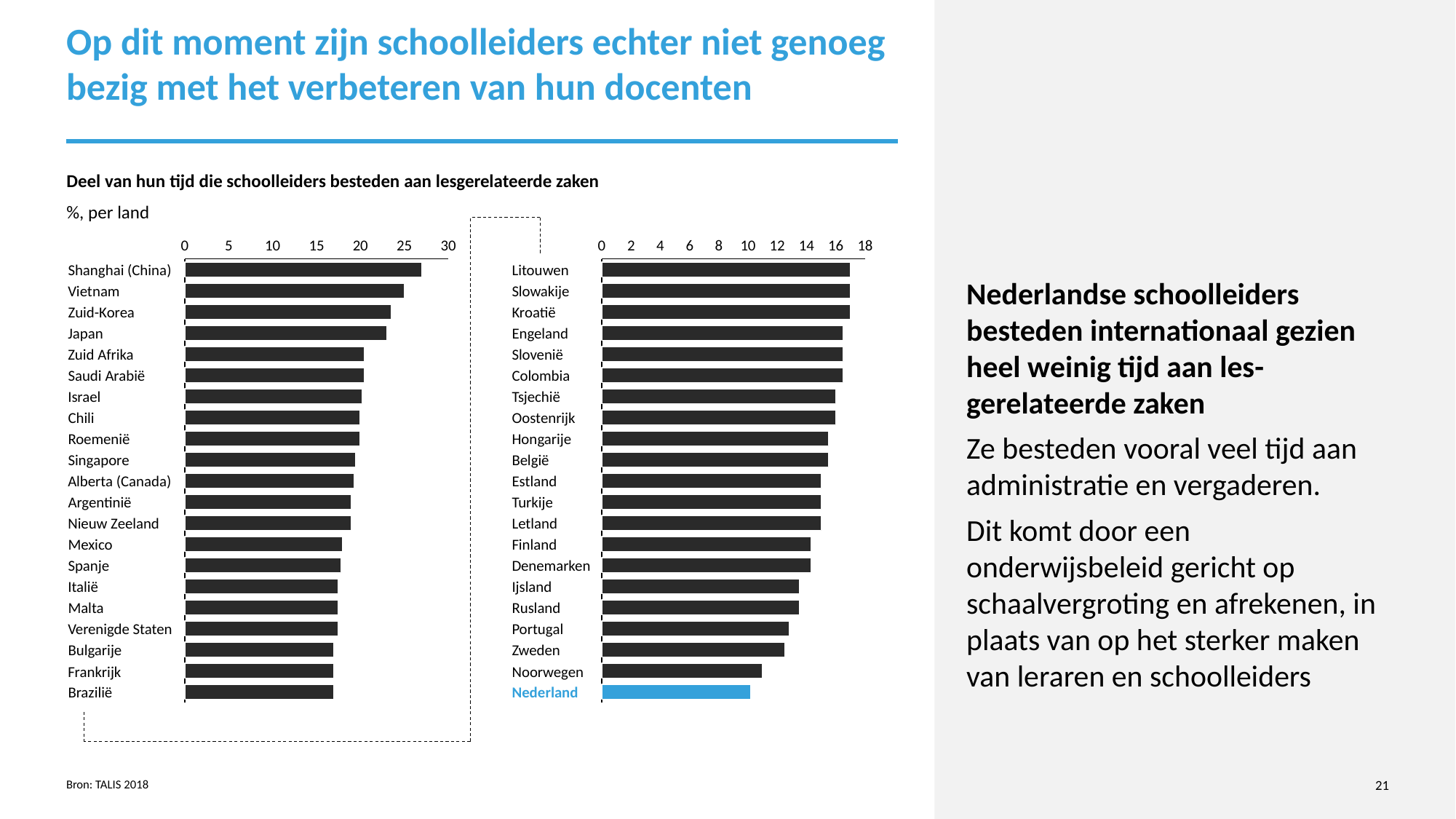
In the right chart, do the values rise or fall going from the top country to the bottom country? fall In the left chart, which is larger, the value for Vietnam or the value for Japan? Vietnam In the right chart, is the value for Nederland greater or less than 12? less In the right chart, which country's bar is highlighted in blue? Nederland In the right chart, which country has the lowest value? Nederland In the left chart, which country has the highest value? Shanghai (China) In the right chart, is the value for Litouwen greater or less than 16? greater How many countries are shown in the right chart? 21 In the left chart, is the value for Brazilië greater or less than 20? less What kind of chart is used on the left side of the slide? bar chart How many countries are shown in the left chart? 21